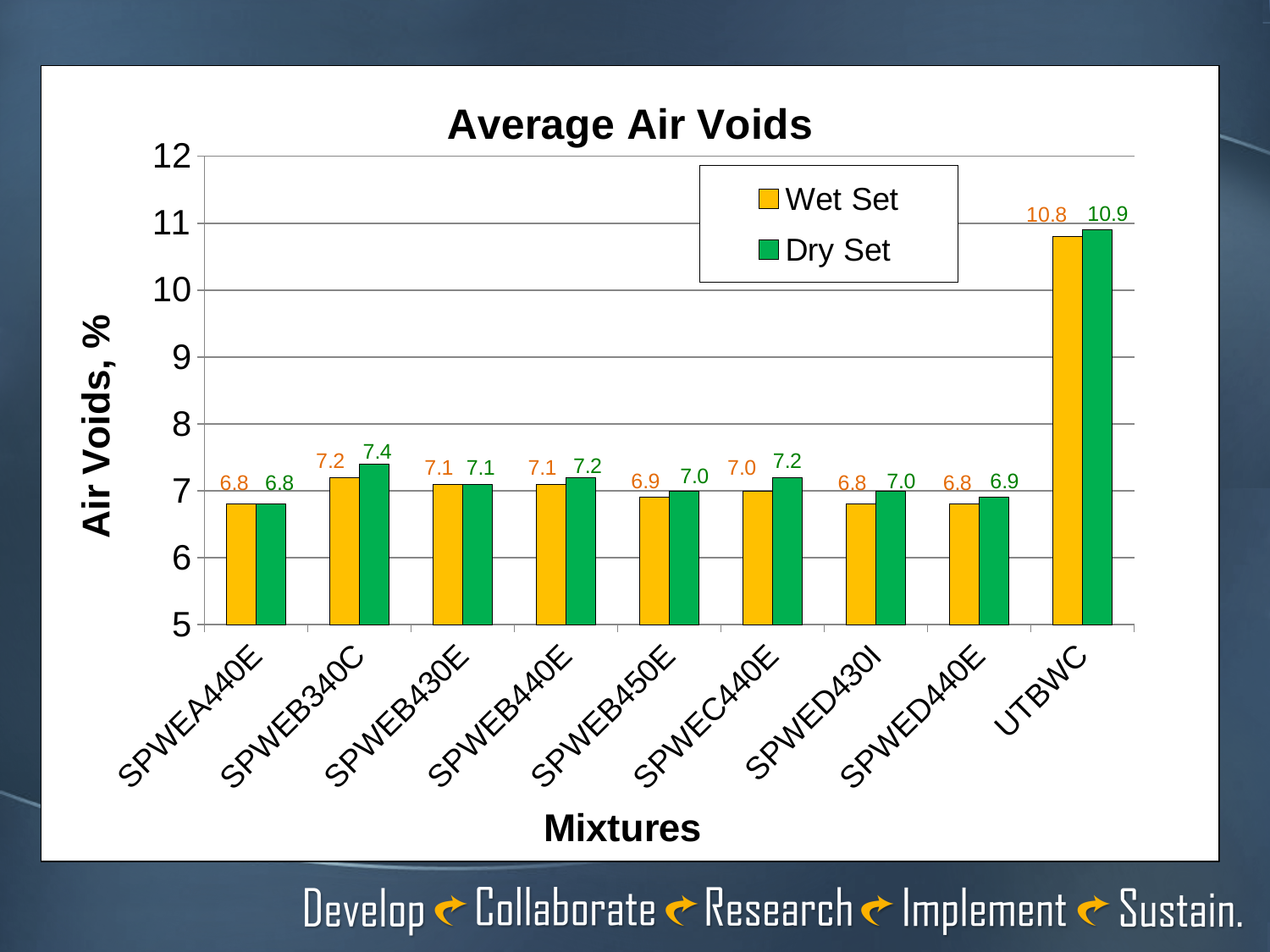
Is the Wet Set value for UTBWC greater or less than 10? greater How many series does the legend list? 2 What is the Wet Set value for UTBWC? 10.8 What is the Dry Set value for SPWEB340C? 7.4 What kind of chart is shown? bar chart What is the difference between the Dry Set and Wet Set values for SPWEC440E? 0.2 What is the title of the chart? Average Air Voids What is the Wet Set value for SPWEB450E? 6.9 What is the label of the y axis? Air Voids, % Which mixture has the highest Dry Set air voids? UTBWC How many mixtures are shown on the x axis? 9 Which is larger for SPWED430I, the Wet Set or the Dry Set value? Dry Set